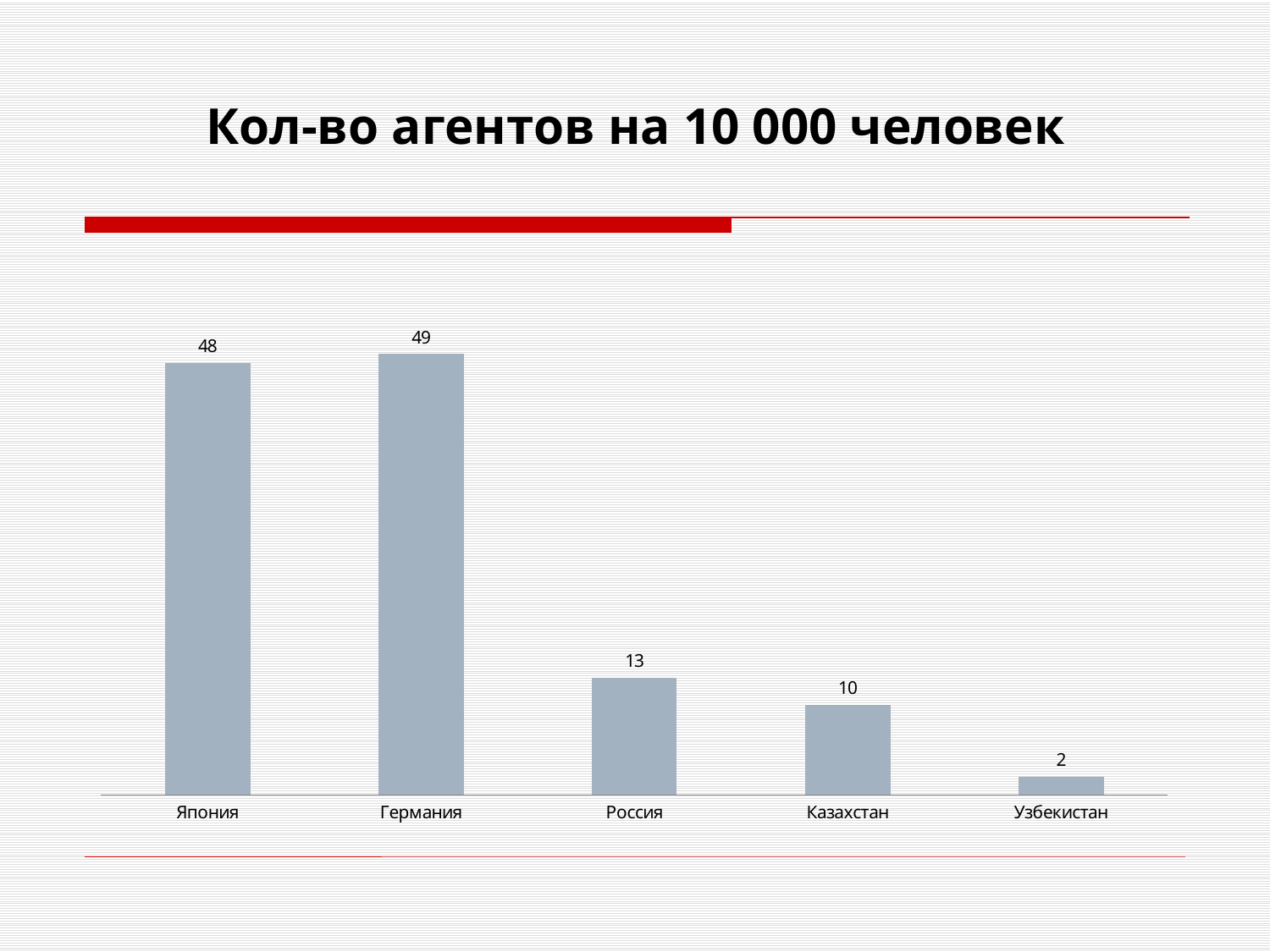
Which category has the lowest value? Узбекистан What is the value for Узбекистан? 2 Which is larger, the value for Россия or the value for Казахстан? Россия How many categories are shown in the chart? 5 What is the value for Япония? 48 What kind of chart is shown on the slide? Bar chart What is the value for Россия? 13 Which category has the highest value? Германия What is the title of the slide? Кол-во агентов на 10 000 человек What is the value for Германия? 49 What is the difference between the values for Германия and Россия? 36 What is the value for Казахстан? 10